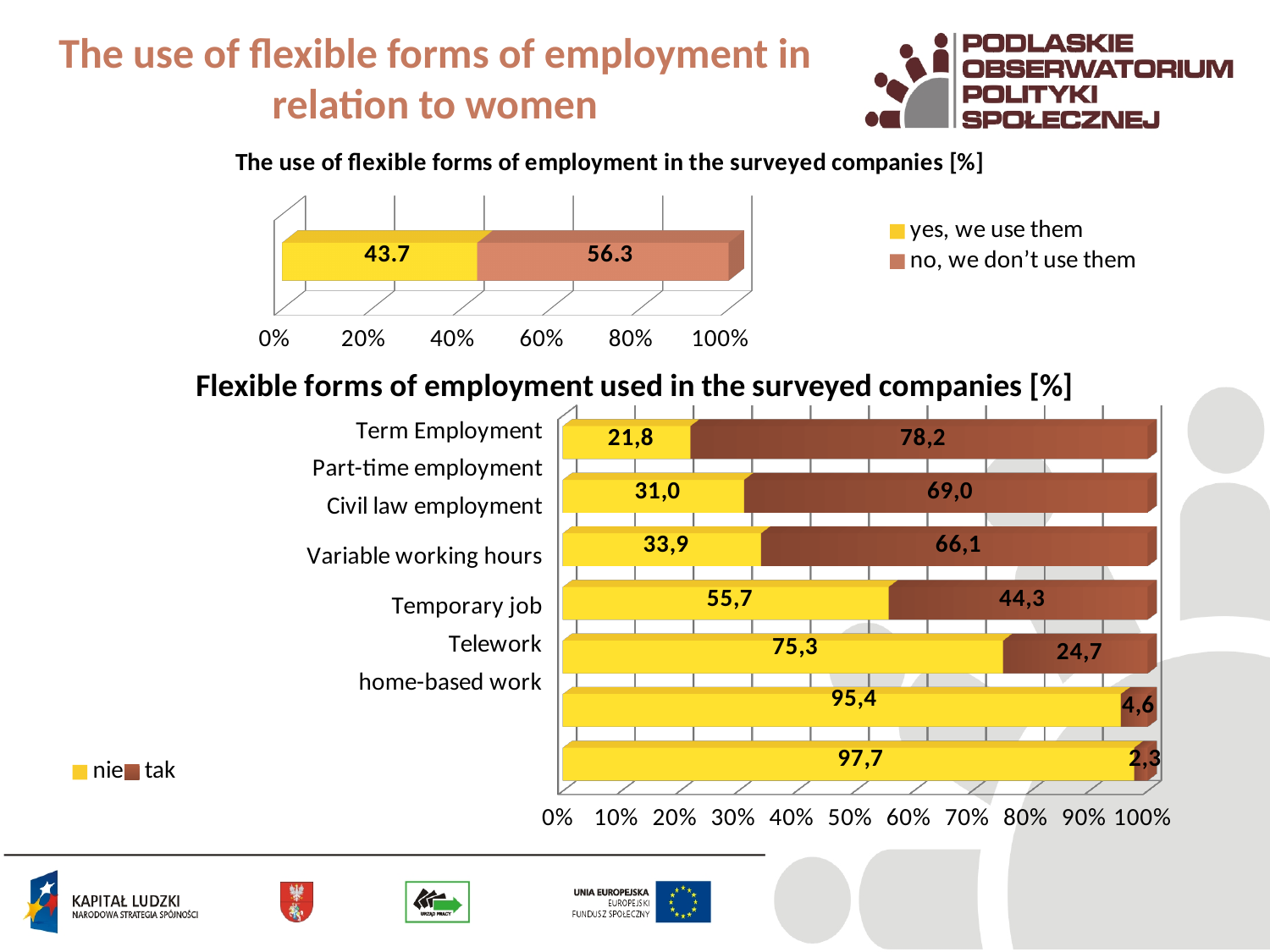
In the bottom chart, which legend entry is shown in yellow? nie What type of chart is the bottom chart, 'Flexible forms of employment used in the surveyed companies [%]'? stacked bar chart In the top chart, what is the difference between the 'no, we don't use them' share and the 'yes, we use them' share? 12.6 How many categories are shown in the bottom chart? 7 In the bottom chart, what is the 'nie' value for home-based work? 97,7 In the bottom chart, what is the 'tak' value for Term Employment? 78,2 In the bottom chart, which category has the lowest 'tak' value? home-based work How many series does the legend of the top chart list? 2 In the bottom chart, which category has the highest 'tak' value? Term Employment In the top chart, which answer has the larger share: 'yes, we use them' or 'no, we don't use them'? no, we don't use them In the top chart, what percentage of surveyed companies answered 'no, we don't use them'? 56.3 In the top chart, what percentage of surveyed companies answered 'yes, we use them'? 43.7